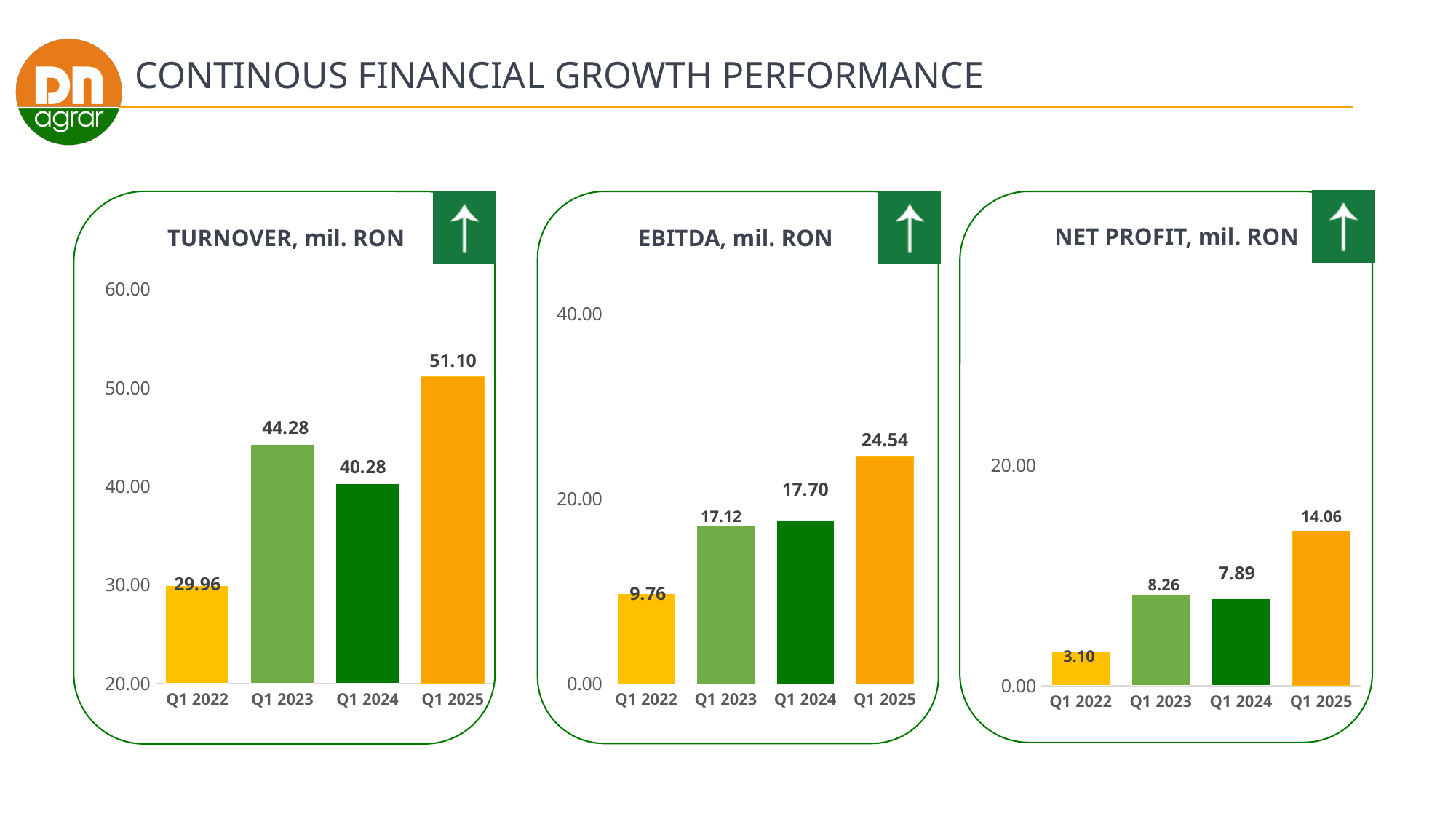
In the EBITDA, mil. RON chart, is the value for Q1 2022 greater or less than 20.00? less In the TURNOVER, mil. RON chart, which quarter has the lowest value? Q1 2022 How many quarters are shown in the TURNOVER, mil. RON chart? 4 In the NET PROFIT, mil. RON chart, what is the value for Q1 2022? 3.10 What kind of chart is the EBITDA, mil. RON chart? bar chart In the EBITDA, mil. RON chart, which quarter has the highest value? Q1 2025 In the EBITDA, mil. RON chart, what is the value for Q1 2023? 17.12 How many charts are on the slide? 3 In the NET PROFIT, mil. RON chart, what is the difference between Q1 2025 and Q1 2024? 6.17 In the TURNOVER, mil. RON chart, what is the value for Q1 2025? 51.10 In the NET PROFIT, mil. RON chart, which is larger, Q1 2023 or Q1 2024? Q1 2023 In the TURNOVER, mil. RON chart, what is the difference between Q1 2023 and Q1 2024? 4.00